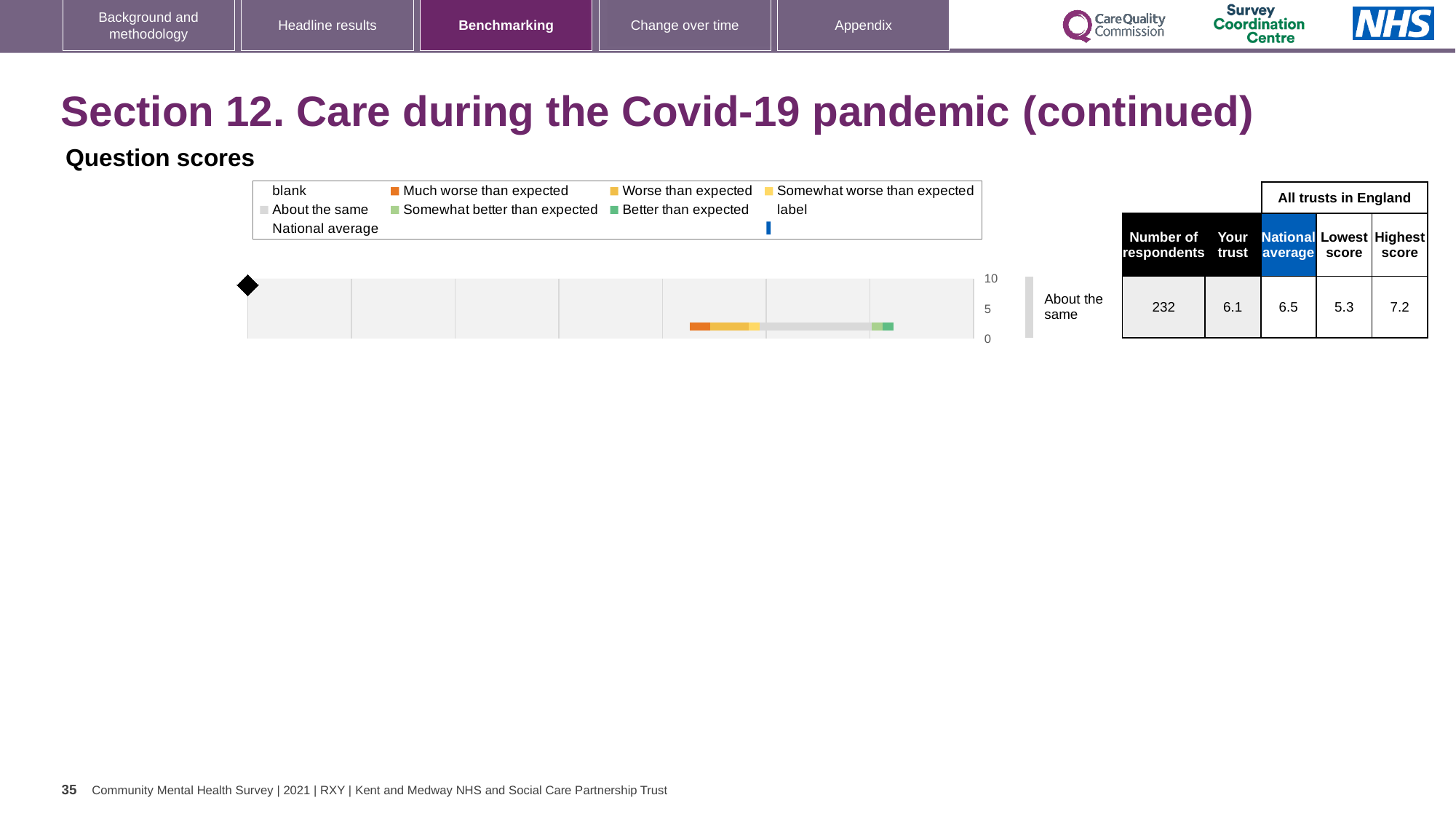
Which benchmarking category is the trust's result labelled as next to the chart? About the same What is the lowest score among all trusts in England shown in the table? 5.3 What is the 'Your trust' score shown in the table next to the chart? 6.1 How many respondents are shown in the table for this question? 232 Which is larger, the 'Your trust' score or the national average? National average What kind of chart is shown on the slide? bar chart What is the maximum value shown on the chart's axis? 10 What is the difference between the highest score (7.2) and the lowest score (5.3)? 1.9 What is the highest score among all trusts in England shown in the table? 7.2 What is the difference between the national average (6.5) and the 'Your trust' score (6.1)? 0.4 What is the national average score shown in the table next to the chart? 6.5 What colour does the legend use for 'Much worse than expected'? Orange